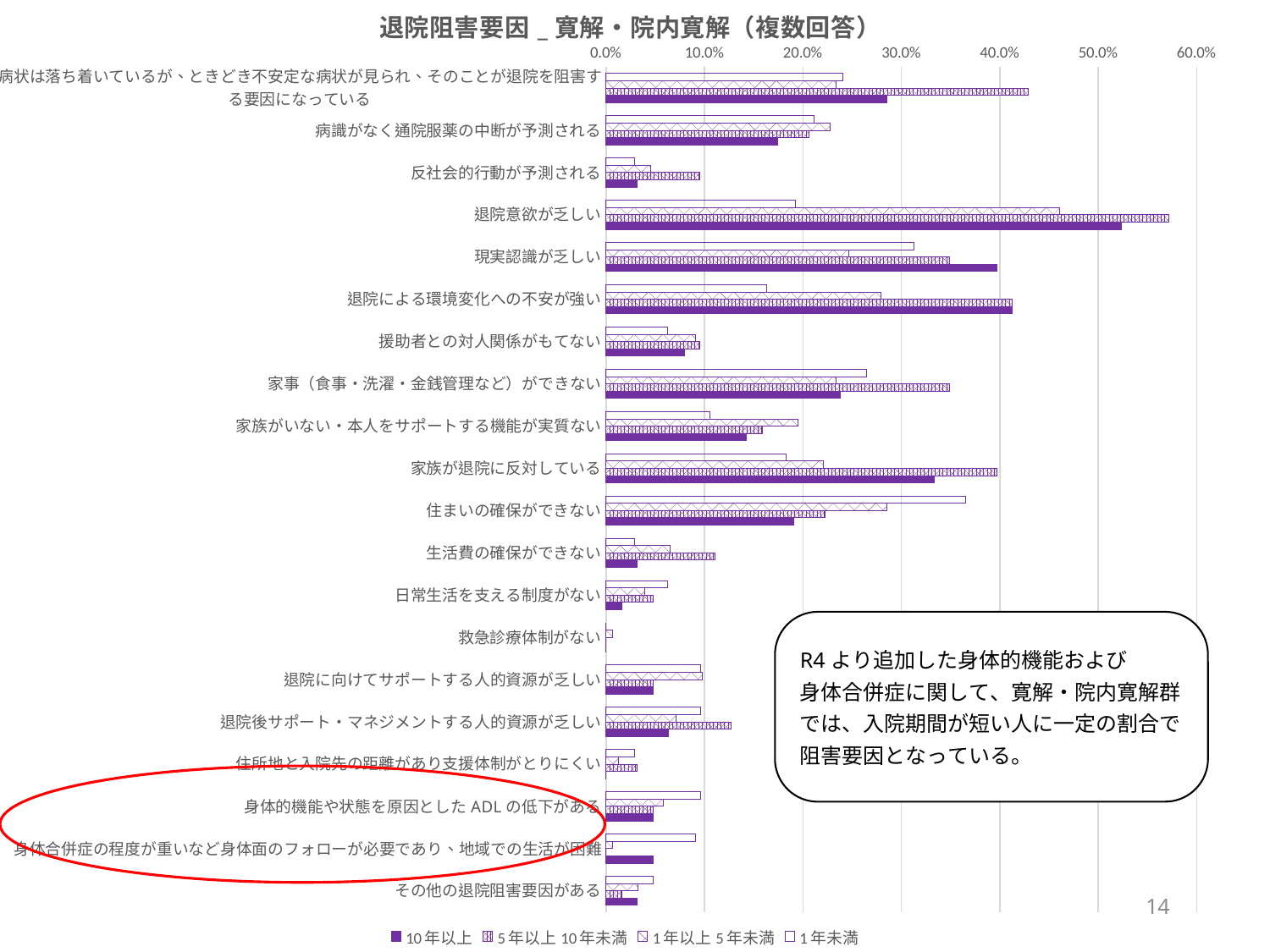
Which series is drawn as a solid purple bar? 10年以上 Which category has the lowest values across all series? 救急診療体制がない For 住まいの確保ができない, which is larger: the 1年未満 value or the 10年以上 value? 1年未満 Is the 10年以上 value for 反社会的行動が予測される greater or less than 10.0%? less Is the 1年未満 value for 住まいの確保ができない greater or less than 30.0%? greater For the 5年以上10年未満 series, which category has the highest value? 退院意欲が乏しい How many categories are plotted on the chart? 20 What is the title of the chart? 退院阻害要因＿寛解・院内寛解（複数回答） Is the 10年以上 value for 退院意欲が乏しい greater or less than 50.0%? greater What kind of chart is shown on the slide? bar chart How many series does the legend list? 4 For the 10年以上 series, which category has the highest value? 退院意欲が乏しい